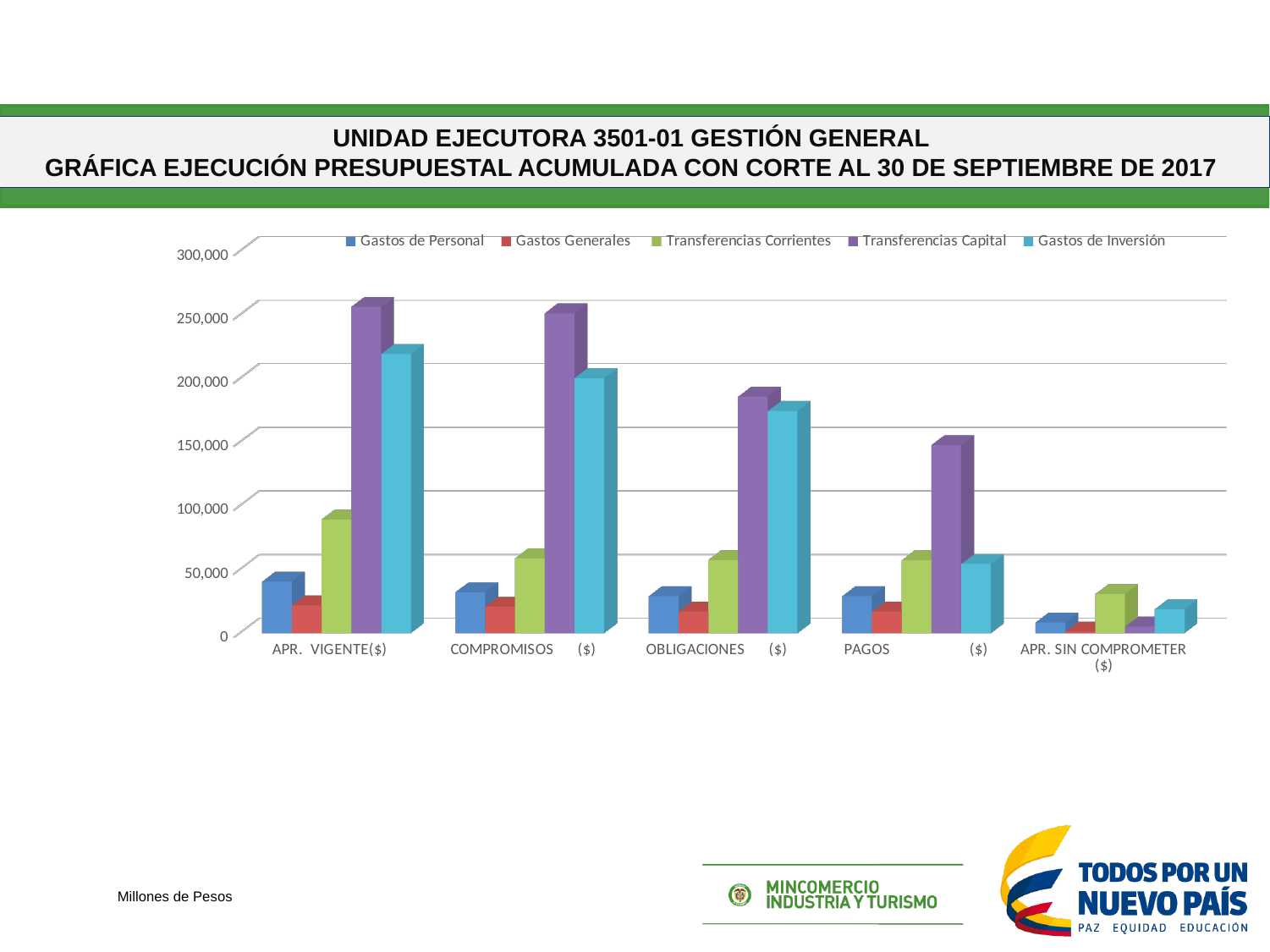
Is the value of Transferencias Corrientes for APR. VIGENTE($) greater or less than 100,000? less Is the value of Gastos de Inversión for PAGOS ($) greater or less than 100,000? less Is the value of Transferencias Capital for APR. VIGENTE($) greater or less than 200,000? greater Does the value of Transferencias Capital rise or fall from APR. VIGENTE($) through PAGOS ($)? fall What is the highest tick value shown on the vertical axis? 300,000 What colour represents Transferencias Capital in the legend? purple How many series does the legend list? 5 Within the APR. SIN COMPROMETER ($) category, which series has the highest value? Transferencias Corrientes What kind of chart is shown on the slide? bar chart How many categories are shown along the x axis? 5 Within the APR. VIGENTE($) category, which series has the highest value? Transferencias Capital For PAGOS ($), which is larger: Transferencias Capital or Gastos de Inversión? Transferencias Capital